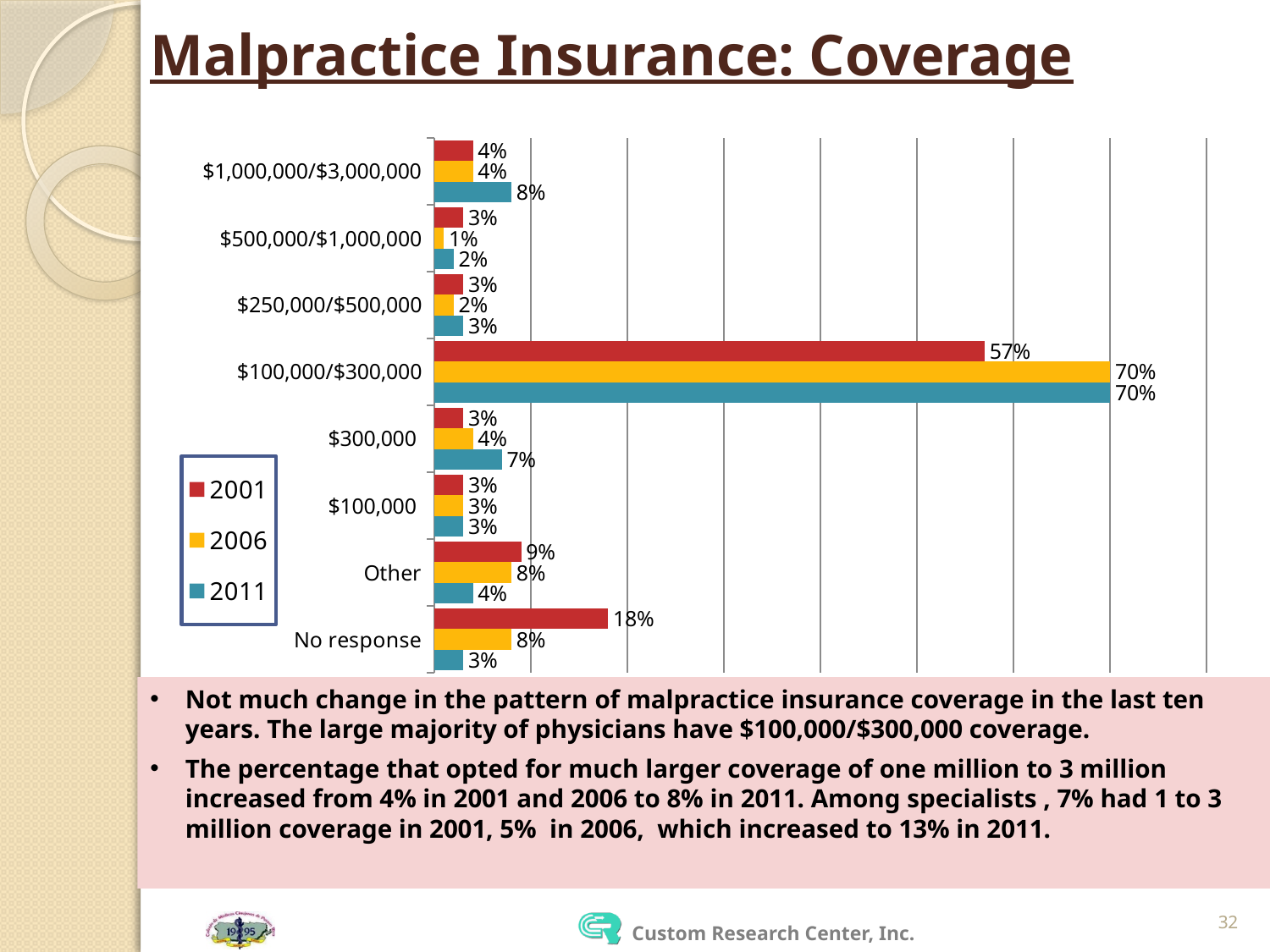
How many coverage categories are shown on the chart? 8 What percentage of physicians had $100,000/$300,000 coverage in 2001? 57% What is the 2001 value for the No response category? 18% What type of chart is shown on the slide? Bar chart Which is larger for the Other category, the 2001 value or the 2011 value? 2001 What is the 2011 value for $1,000,000/$3,000,000 coverage? 8% What is the difference between the 2001 and 2011 values for No response? 15% Which coverage category has the highest value for 2006? $100,000/$300,000 What is the difference between the 2006 and 2001 values for $100,000/$300,000 coverage? 13% What is the 2006 value for $500,000/$1,000,000 coverage? 1% Which category has the lowest value for 2006? $500,000/$1,000,000 How many series does the legend list? 3